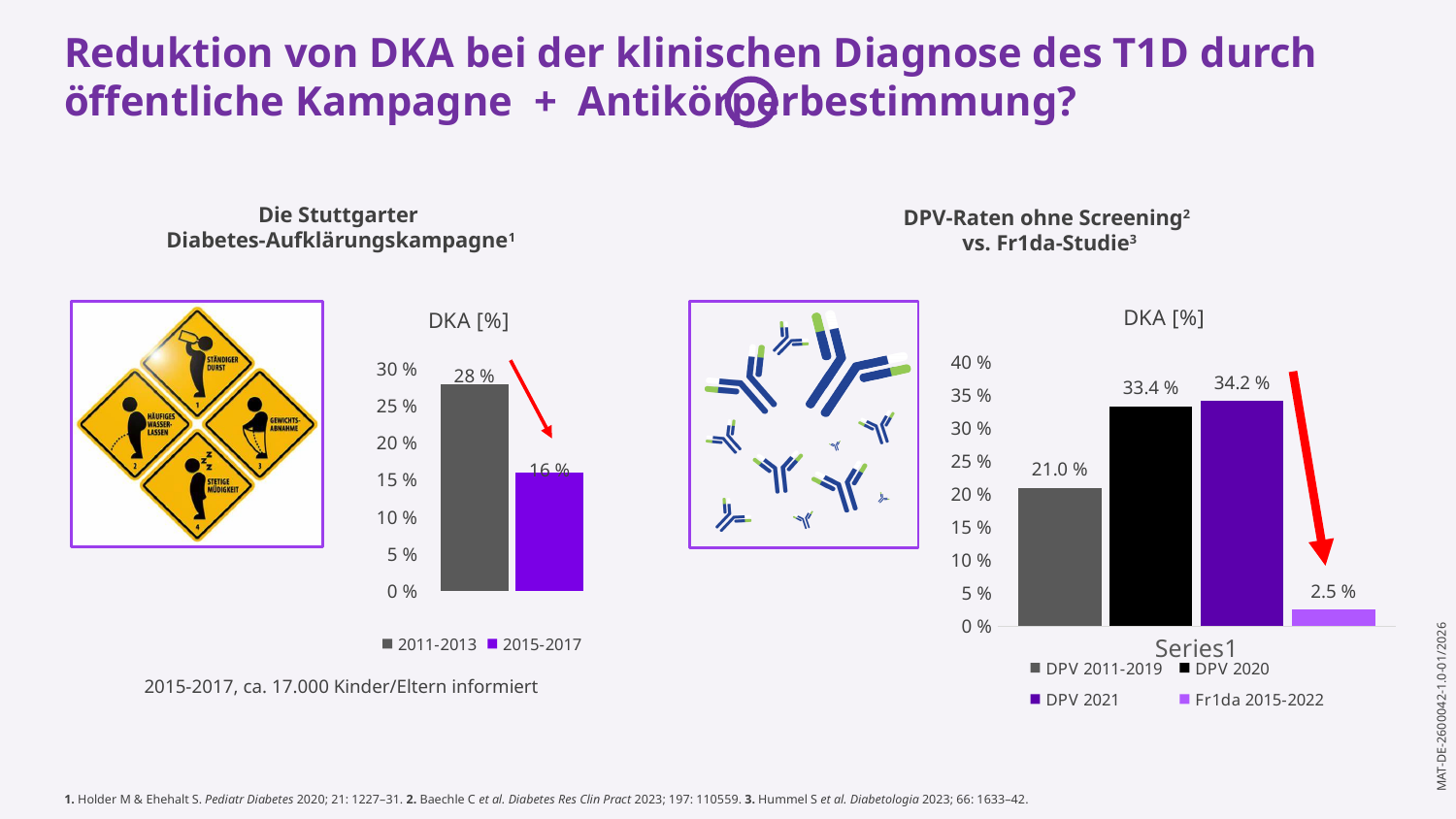
In the left chart, what is the DKA value for 2015-2017? 16 % What kind of chart is the right chart? bar chart In the left chart, do the values rise or fall from 2011-2013 to 2015-2017? fall In the right chart, what is the DKA value for DPV 2020? 33.4 % In the right chart, what is the difference between the DPV 2021 and Fr1da 2015-2022 values? 31.7 % In the right chart, which series has the highest value? DPV 2021 In the left chart, what is the difference between the 2011-2013 and 2015-2017 values? 12 % In the left chart, what is the DKA value for 2011-2013? 28 % In the left chart, how many series does the legend list? 2 In the right chart, which series has the lowest value? Fr1da 2015-2022 In the right chart, what is the DKA value for Fr1da 2015-2022? 2.5 % In the right chart, how many series does the legend list? 4